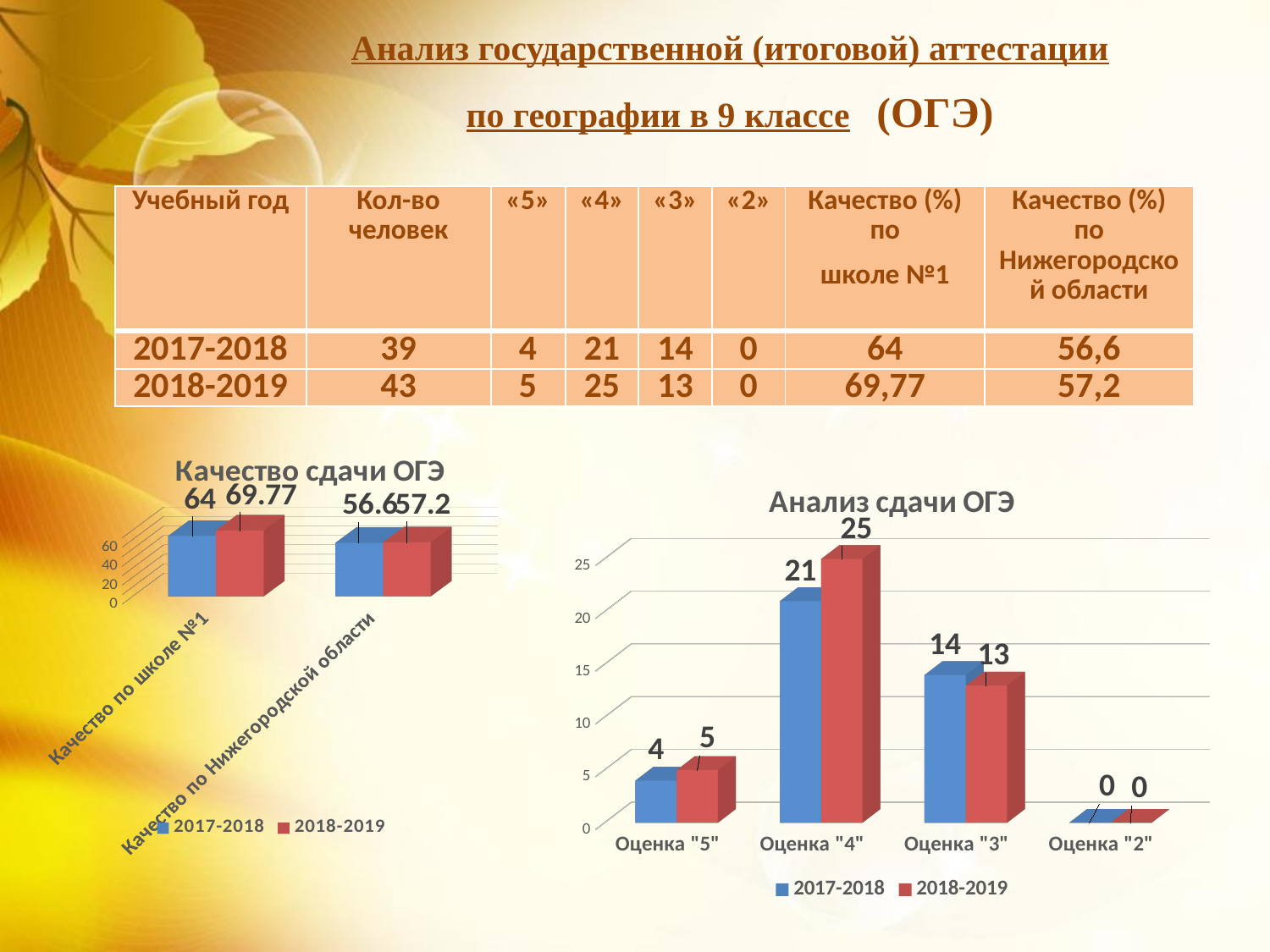
In the chart titled "Анализ сдачи ОГЭ", how many series does the legend list? 2 In the chart titled "Анализ сдачи ОГЭ", which category has the lowest value for the 2018-2019 series? Оценка "2" In the chart titled "Анализ сдачи ОГЭ", what is the difference between the 2018-2019 and 2017-2018 values at Оценка "4"? 4 What kind of chart is the one titled "Качество сдачи ОГЭ"? Bar chart In the chart titled "Анализ сдачи ОГЭ", what is the value for 2017-2018 at Оценка "3"? 14 In the chart titled "Анализ сдачи ОГЭ", how many categories are shown on the x axis? 4 In the chart titled "Анализ сдачи ОГЭ", which category has the highest value for the 2017-2018 series? Оценка "4" In the chart titled "Анализ сдачи ОГЭ", what is the value for 2018-2019 at Оценка "4"? 25 In the chart titled "Анализ сдачи ОГЭ", which series has the larger value at Оценка "3", 2017-2018 or 2018-2019? 2017-2018 In the chart titled "Качество сдачи ОГЭ", what is the value for 2017-2018 at "Качество по Нижегородской области"? 56.6 In the chart titled "Качество сдачи ОГЭ", what is the value for 2018-2019 at "Качество по школе №1"? 69.77 In the chart titled "Качество сдачи ОГЭ", which series has the larger value at "Качество по школе №1", 2017-2018 or 2018-2019? 2018-2019